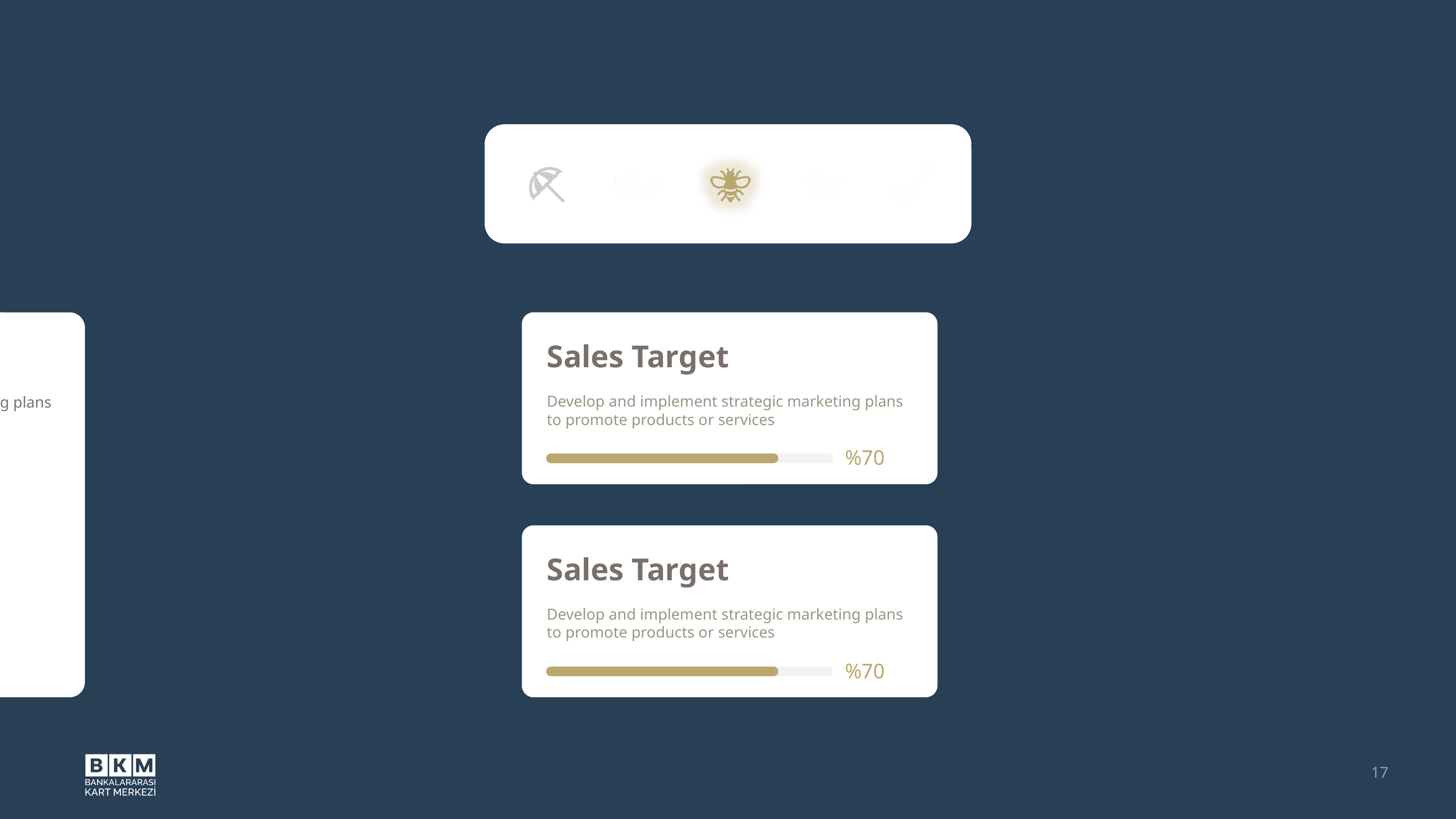
Do the upper and lower Sales Target progress bars show the same value? Yes What colour is the filled portion of the progress bars? Gold How many progress bars are shown on the slide? 2 What value is shown next to the progress bar in the upper Sales Target card? %70 What value is shown next to the progress bar in the lower Sales Target card? %70 What is the title of the card containing the upper progress bar? Sales Target